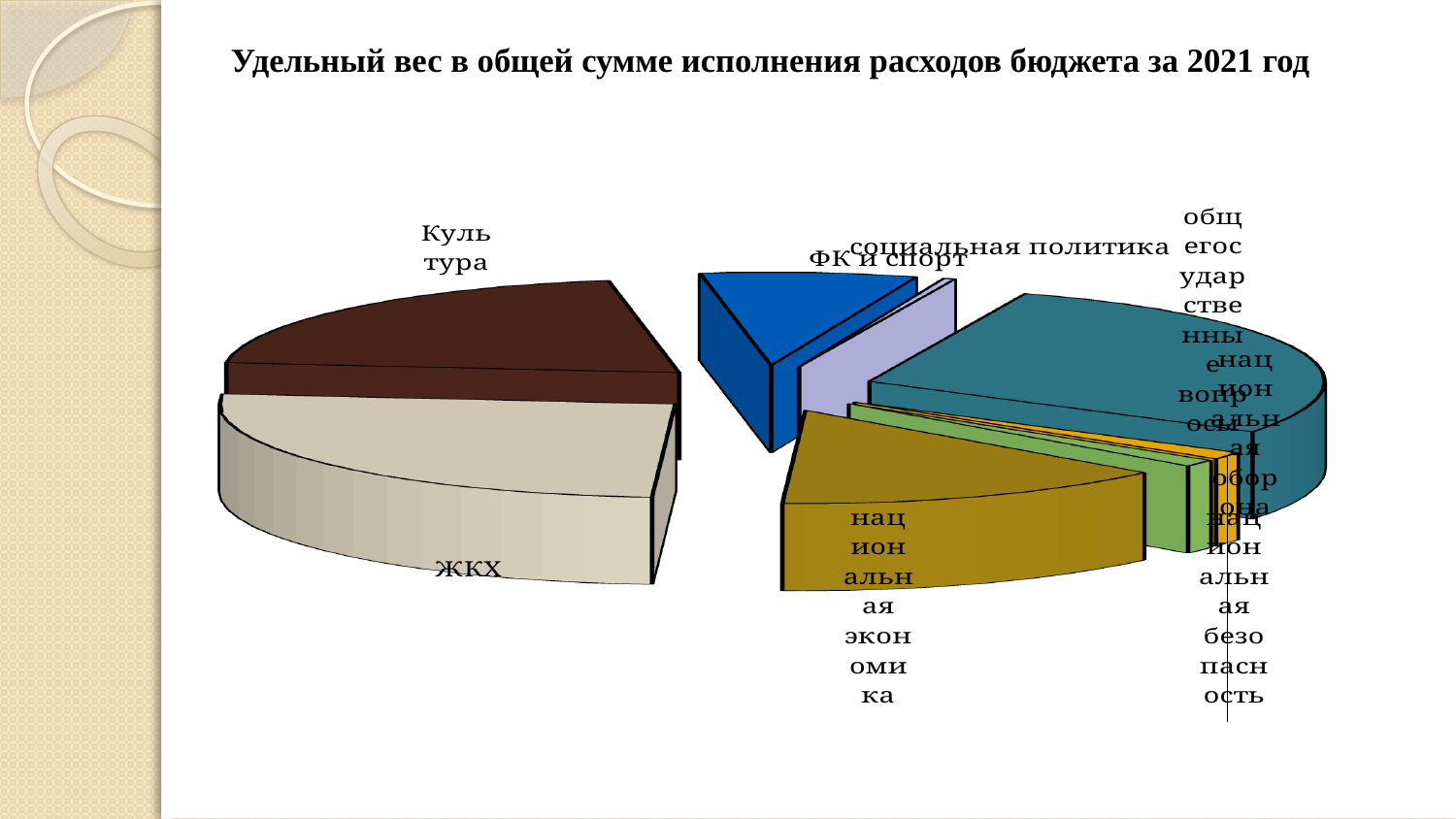
What is the title of the chart? Удельный вес в общей сумме исполнения расходов бюджета за 2021 год Which slice is larger, Культура or ФК и спорт? Культура Which category has the largest slice of the pie? общегосударственные вопросы Which year does the chart refer to? 2021 Which slice is larger, Культура or национальная экономика? Культура Which slice is larger, ЖКХ or социальная политика? ЖКХ What kind of chart is shown on the slide? Pie chart